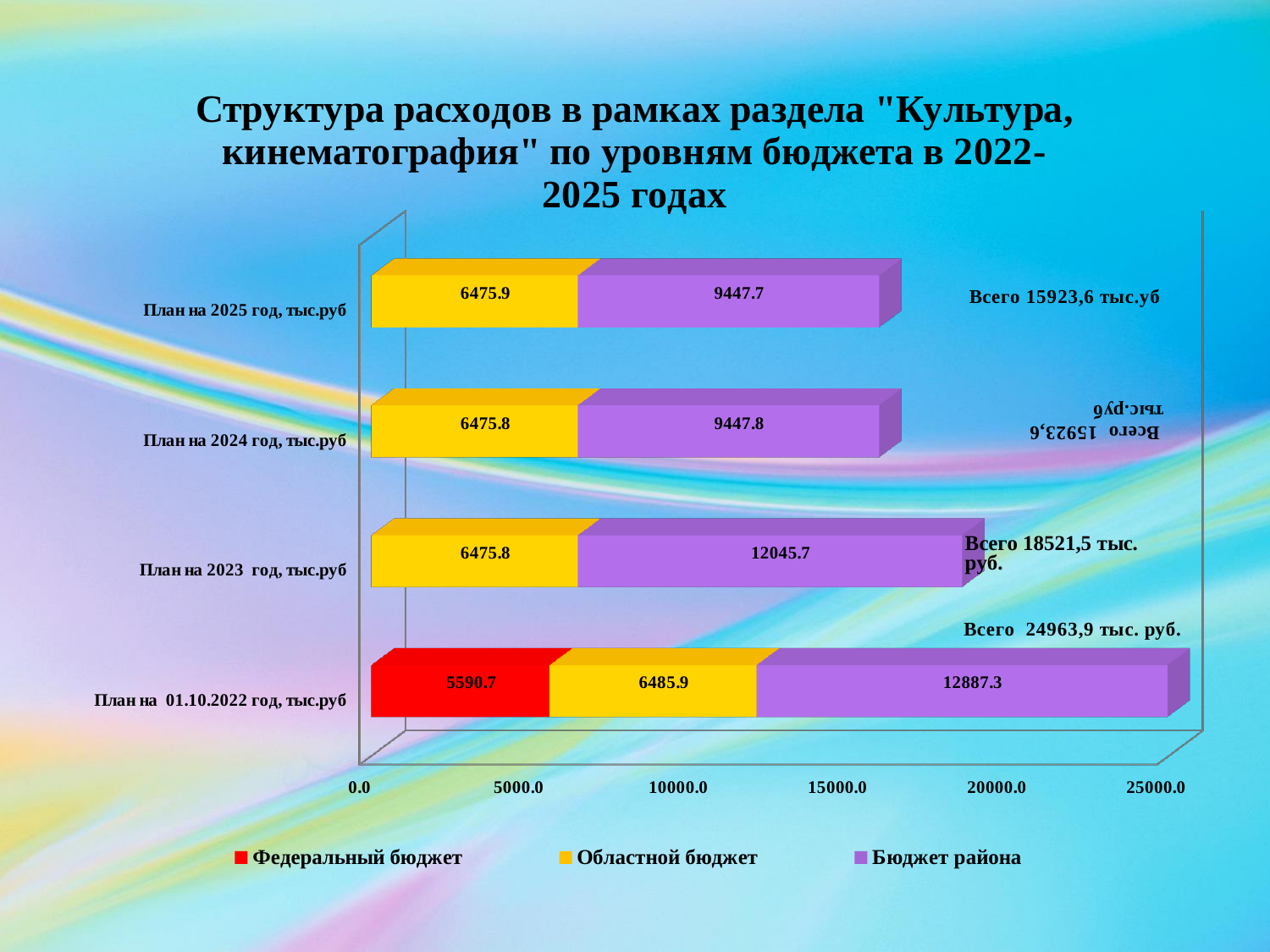
What is the value of Областной бюджет for План на 2025 год? 6475.9 Which series is shown in red in the legend? Федеральный бюджет What is the total shown for План на 2023 год? 18521,5 тыс. руб. What is the value of Федеральный бюджет for План на 01.10.2022 год? 5590.7 Which category has the largest Бюджет района value? План на 01.10.2022 год, тыс.руб Which is larger: Бюджет района for План на 2023 год or for План на 2025 год? План на 2023 год What type of chart is shown on the slide? stacked bar chart How many categories (plan years) are plotted on the chart? 4 What is the value of Бюджет района for План на 2023 год? 12045.7 Which category has the largest total expenditure? План на 01.10.2022 год, тыс.руб What is the difference between the Бюджет района values for План на 01.10.2022 год and План на 2023 год? 841.6 How many series does the legend list? 3